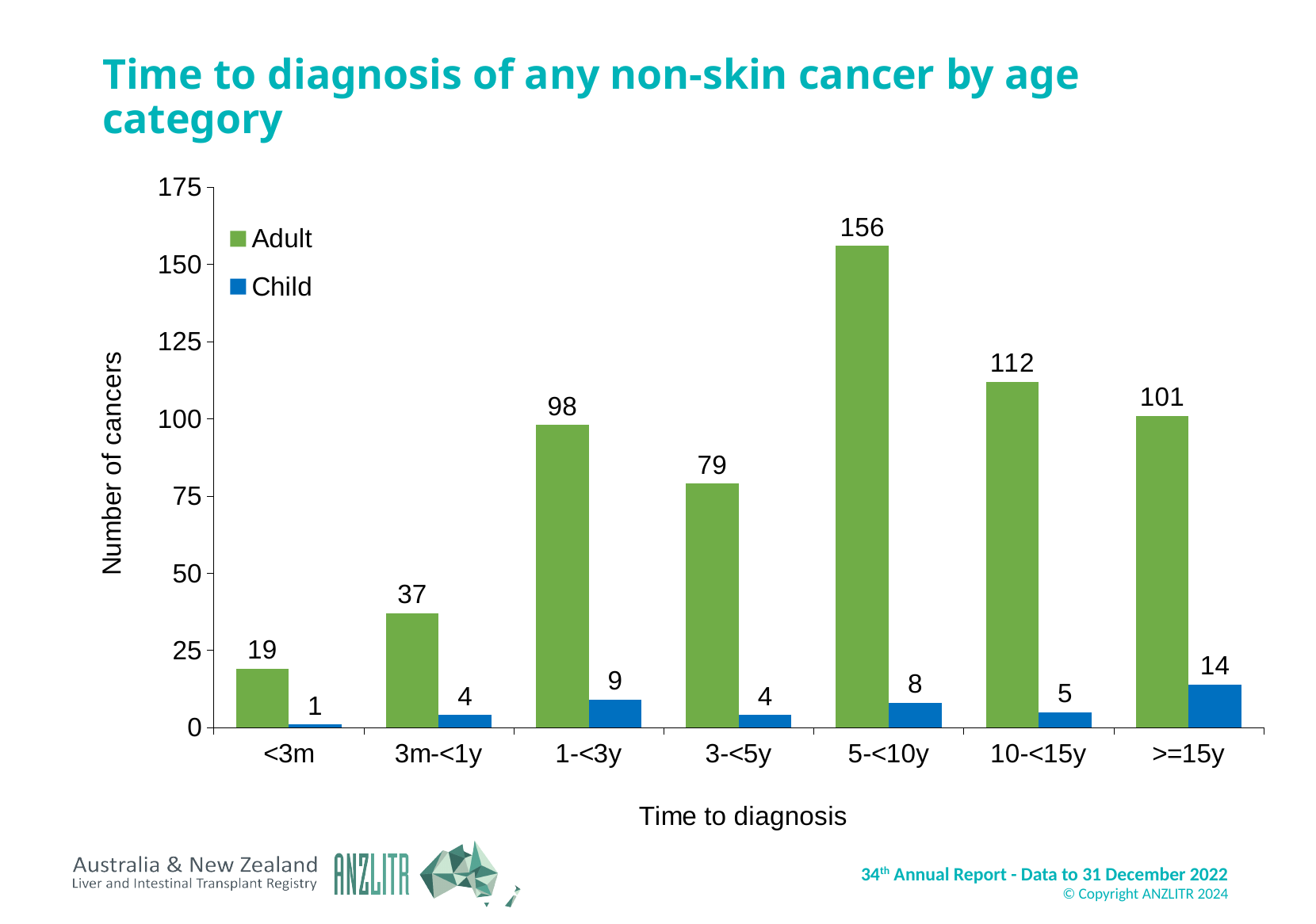
Is the Adult value for 3-<5y greater or less than 100? less What is the label of the y axis? Number of cancers What kind of chart is shown on the slide? bar chart Which time to diagnosis category has the highest Adult value? 5-<10y How many time to diagnosis categories are shown on the x axis? 7 What is the Adult value for the 3m-<1y category? 37 Which time to diagnosis category has the lowest Child value? <3m What is the Child value for the >=15y time to diagnosis category? 14 How many series does the legend list? 2 What is the difference between the Adult values for 5-<10y and 10-<15y? 44 Which is larger, the Adult value for 1-<3y or the Adult value for >=15y? >=15y What is the Adult value for the 5-<10y time to diagnosis category? 156